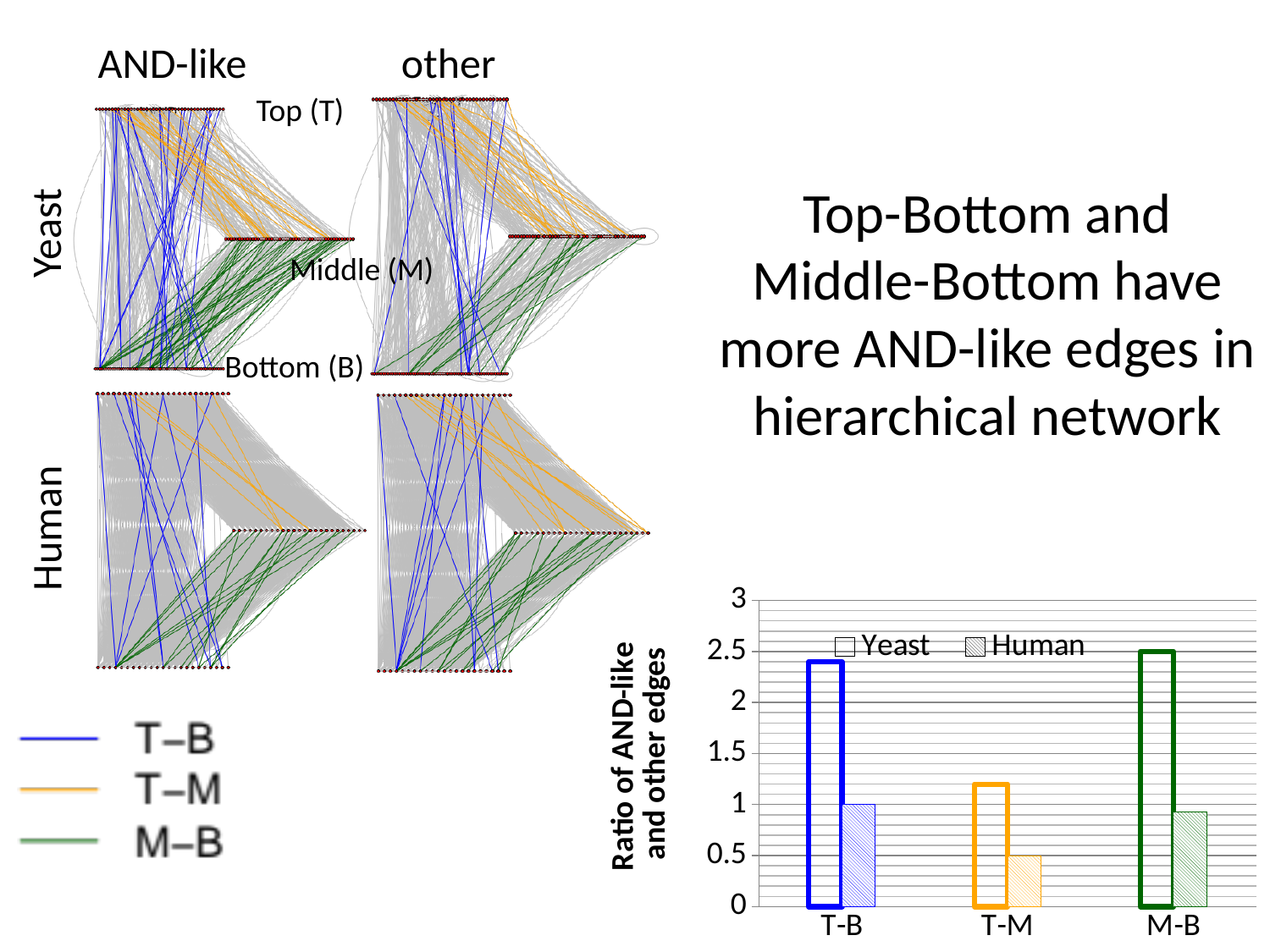
How many series does the legend of the bar chart list? 2 In the bar chart, is the Yeast value for T-M greater or less than 1? greater What are the two entries in the legend of the bar chart? Yeast and Human In the bar chart, for T-B, which series has the larger value, Yeast or Human? Yeast In the bar chart, which category has the lowest value for Yeast? T-M What kind of chart is shown at the bottom right of the slide? bar chart What is the y-axis title of the bar chart? Ratio of AND-like and other edges In the bar chart, which category has the lowest value for Human? T-M In the bar chart, is the Human value for T-M greater or less than 1? less In the bar chart, is the Yeast value for T-B greater or less than 2? greater In the bar chart, which is larger: the Yeast value for T-M or the Human value for M-B? Yeast value for T-M How many categories are shown on the x axis of the bar chart? 3